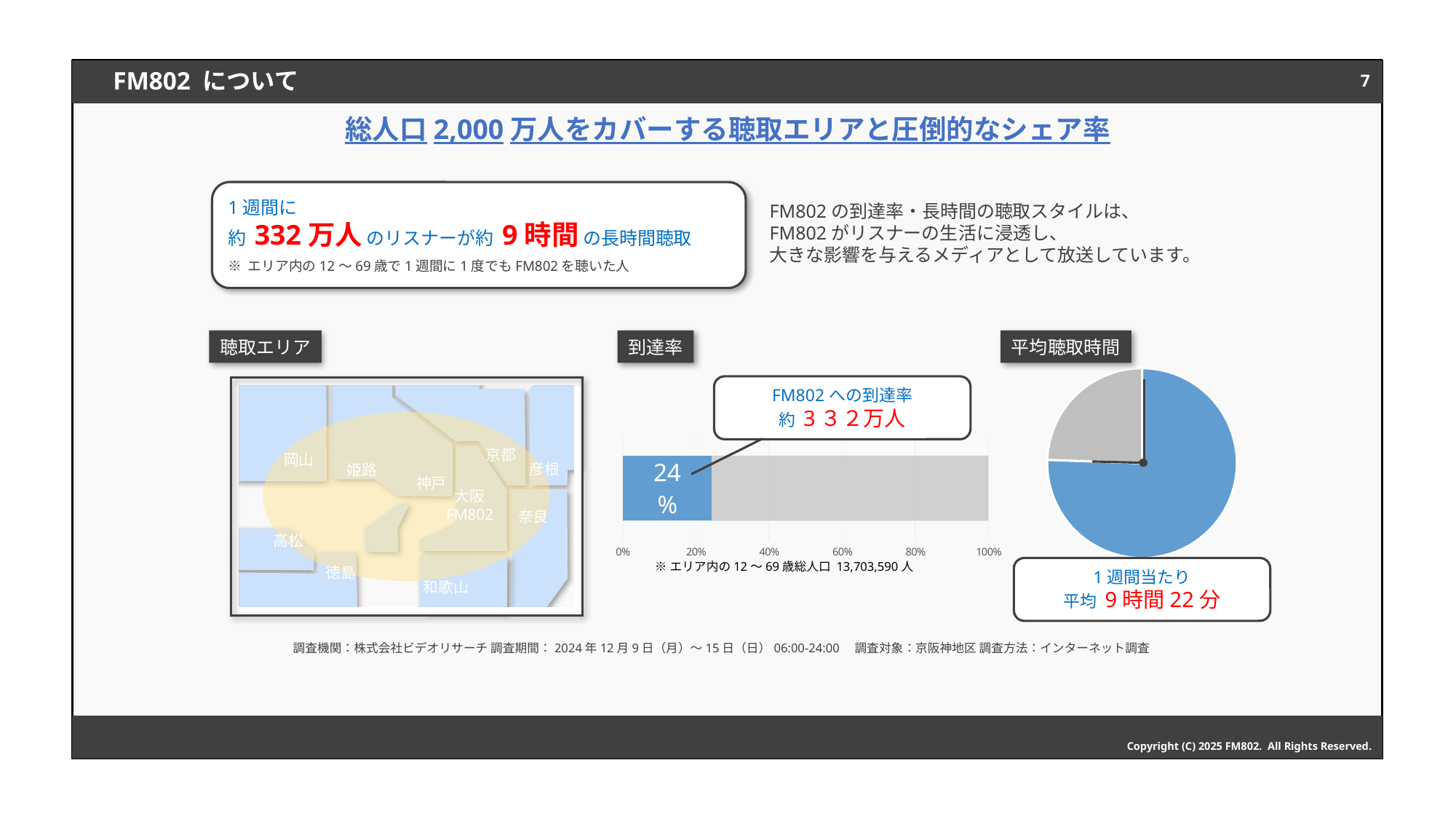
In the 到達率 chart, is the value of the blue bar greater or less than 40%? less What kind of chart is the 到達率 chart? bar chart In the 到達率 chart, what value is printed on the blue bar? 24% How many slices does the 平均聴取時間 pie chart have? 2 How many bars are plotted in the 到達率 chart? 1 In the 到達率 chart, what is the highest value shown on the x axis? 100% In the 到達率 chart, what number of people does the callout give for FM802 への到達率? 約３３２万人 In the 到達率 chart, is the value of the blue bar greater or less than 20%? greater What kind of chart is the 平均聴取時間 chart? pie chart In the 平均聴取時間 pie chart, which slice is larger, the blue one or the grey one? blue In the 平均聴取時間 pie chart, does the blue slice take up more or less than half of the pie? more